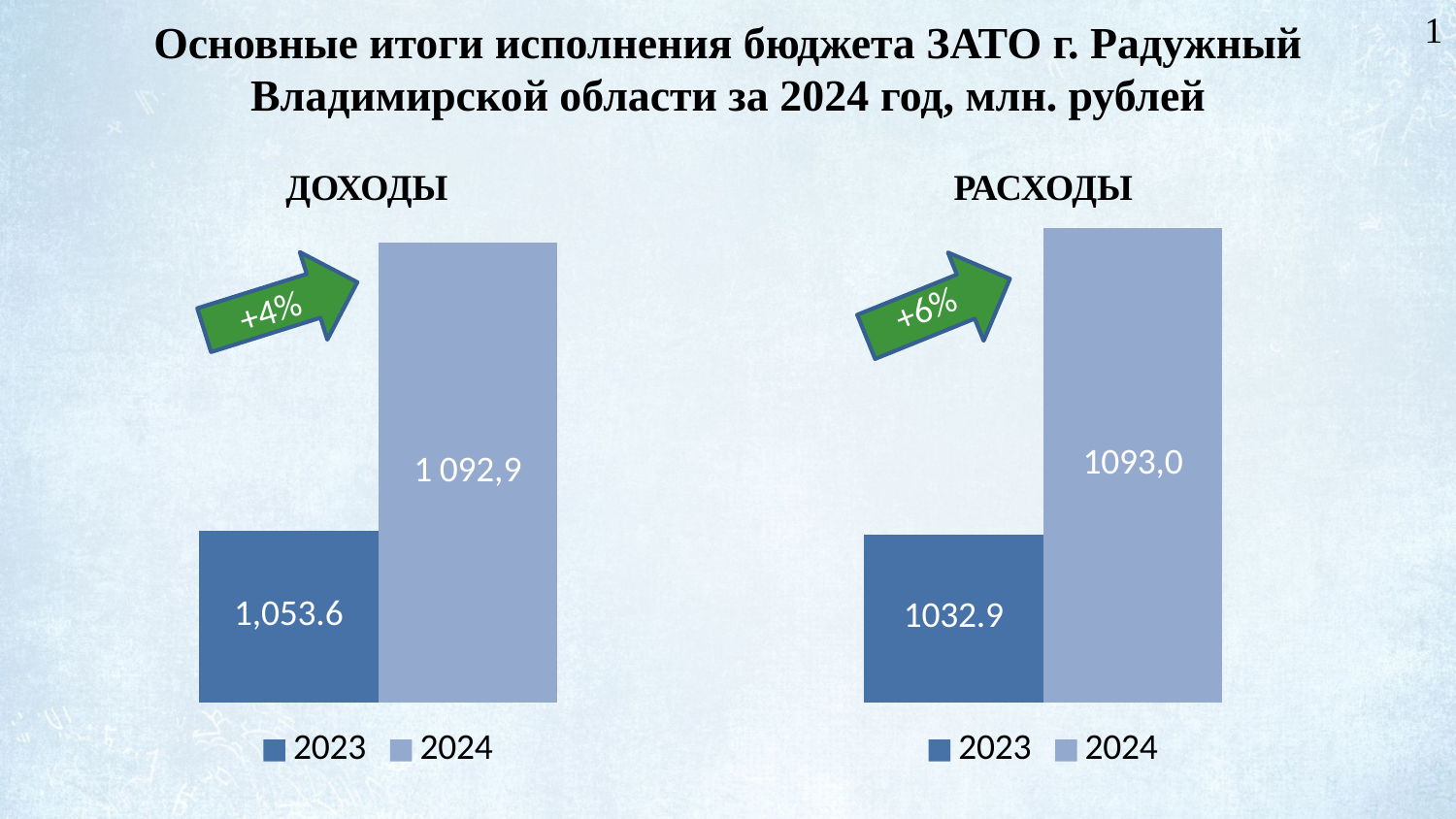
How many series does the legend of the ДОХОДЫ chart list? 2 In the ДОХОДЫ chart, which year has the higher value? 2024 In the РАСХОДЫ chart, by how much did the value increase from 2023 to 2024? 60.1 In the ДОХОДЫ chart, what is the value for 2024? 1 092,9 In the РАСХОДЫ chart, which year has the lower value? 2023 In the ДОХОДЫ chart, by how much did the value increase from 2023 to 2024? 39.3 In the РАСХОДЫ chart, is the value for 2024 larger or smaller than the value for 2023? larger In the РАСХОДЫ chart, what is the value for 2024? 1093,0 What type of chart is the РАСХОДЫ chart? bar chart What percentage change is shown by the arrow on the ДОХОДЫ chart? +4% In the ДОХОДЫ chart, what is the value for 2023? 1,053.6 In the РАСХОДЫ chart, what is the value for 2023? 1032.9